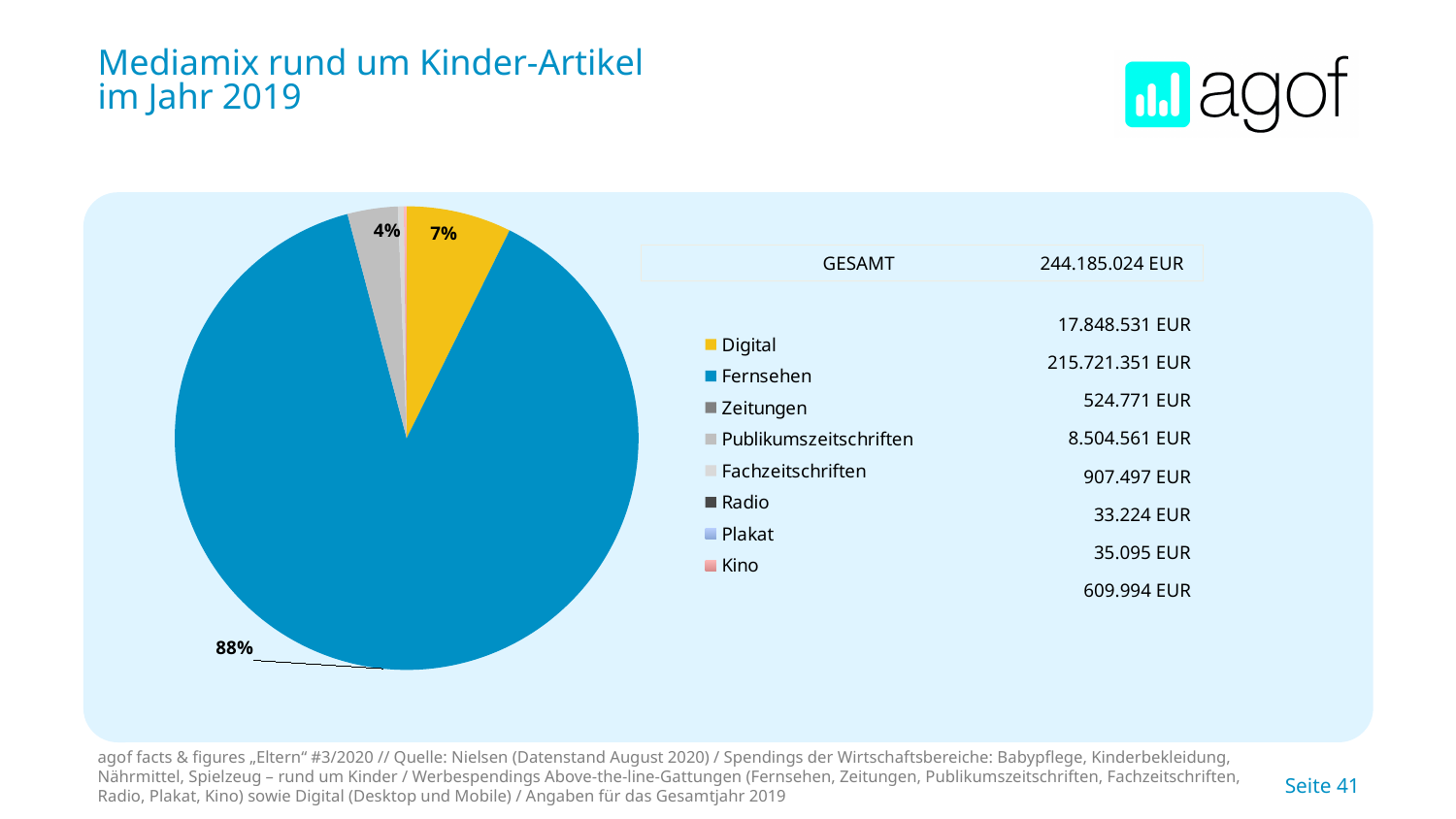
Which category has the smallest value in the list next to the pie chart? Radio What is the value shown for Digital? 17.848.531 EUR What is the value shown for Fernsehen? 215.721.351 EUR What is the title of the slide containing the pie chart? Mediamix rund um Kinder-Artikel im Jahr 2019 Which has the larger value, Digital or Publikumszeitschriften? Digital What kind of chart is shown on the slide? pie chart By how many percentage points does the Fernsehen share exceed the Digital share? 81 percentage points How many categories does the legend of the pie chart list? 8 What is the GESAMT value shown next to the pie chart? 244.185.024 EUR What share of the pie does Fernsehen account for? 88% Which category has the largest slice of the pie? Fernsehen What share of the pie does Digital account for? 7%